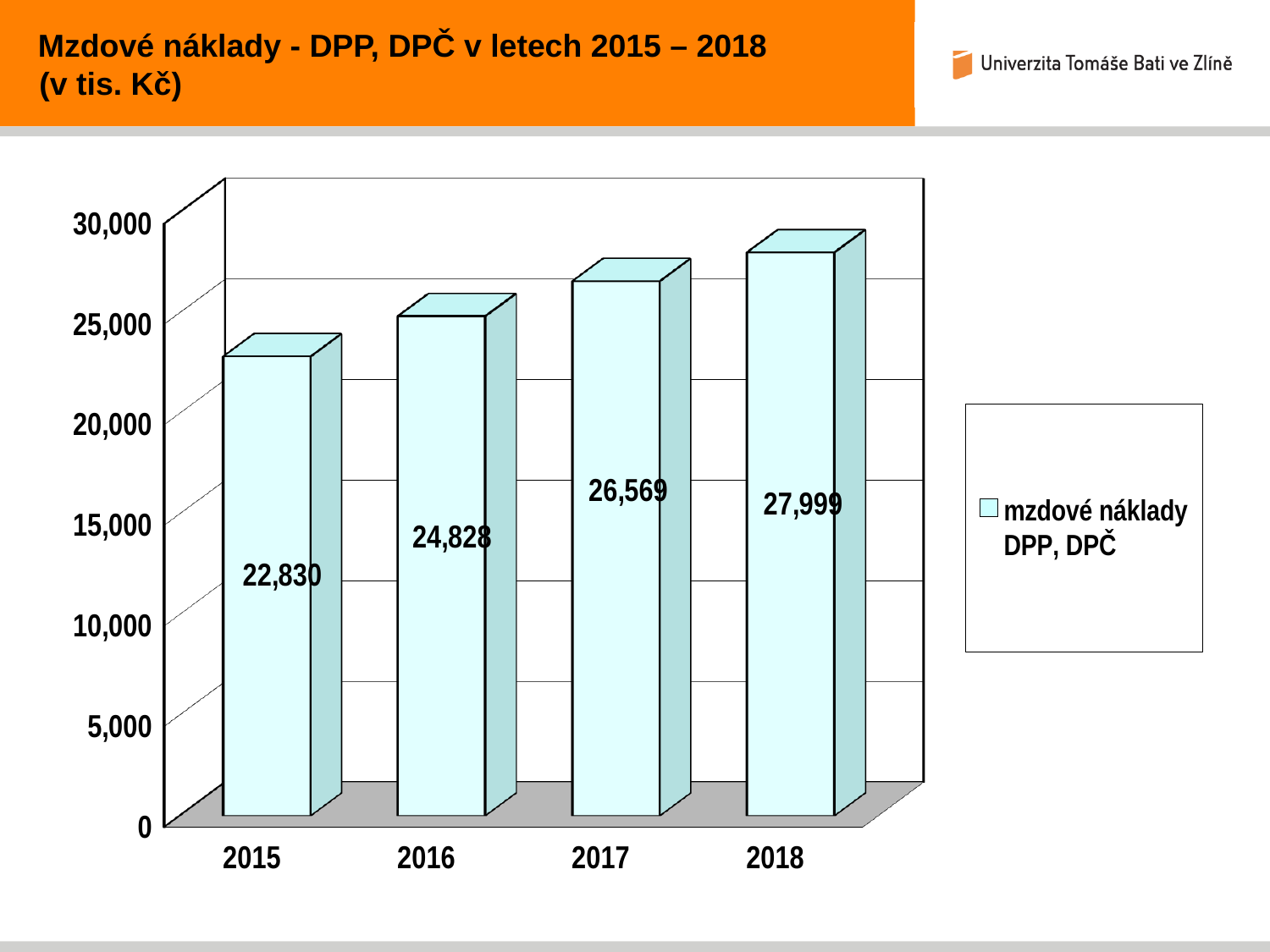
What kind of chart is shown on the slide? bar chart What is the value for 2018? 27,999 Which year has the lowest value? 2015 What is the value for 2017? 26,569 How many years are shown on the x axis? 4 Which is larger, the value for 2016 or the value for 2017? 2017 What is the difference between the values for 2017 and 2016? 1,741 Do the values rise or fall from 2015 to 2018? rise What is the difference between the values for 2018 and 2015? 5,169 Which year has the highest value? 2018 What is the value for 2015? 22,830 What is the value for 2016? 24,828